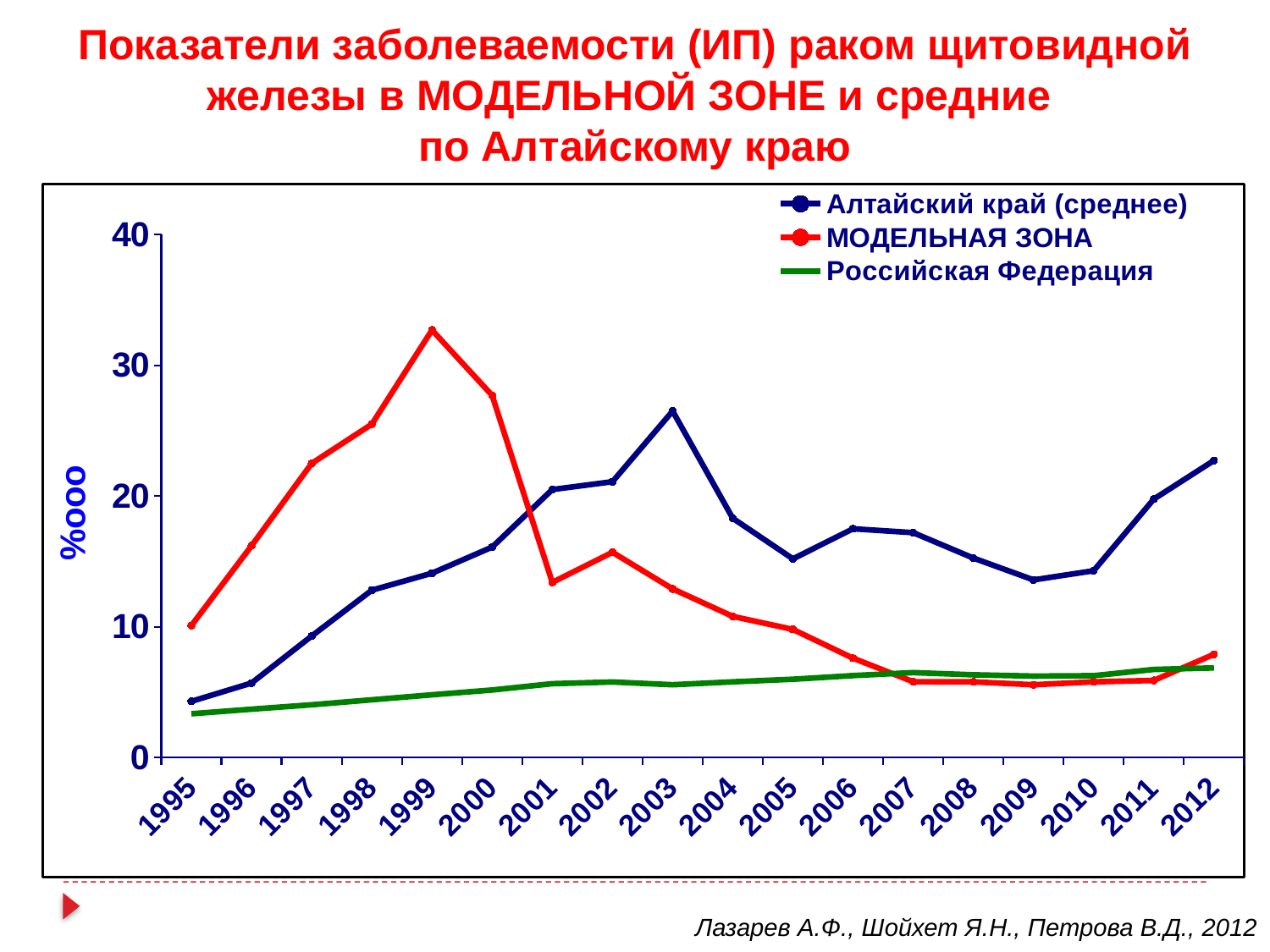
In which year does the Алтайский край (среднее) series reach its highest value? 2003 In which year does the МОДЕЛЬНАЯ ЗОНА series reach its highest value? 1999 How many years are shown along the x axis? 18 What colour is the line for Российская Федерация? green How many series does the legend list? 3 Is the value for Алтайский край (среднее) in 1995 greater or less than 10? less Does the МОДЕЛЬНАЯ ЗОНА series rise or fall from 1999 to 2009? fall What kind of chart is shown on the slide? line chart Which series has the larger value in 2012, Алтайский край (среднее) or МОДЕЛЬНАЯ ЗОНА? Алтайский край (среднее) Is the value for МОДЕЛЬНАЯ ЗОНА in 1999 greater or less than 30? greater Which series has the larger value in 1999, МОДЕЛЬНАЯ ЗОНА or Алтайский край (среднее)? МОДЕЛЬНАЯ ЗОНА Is the value for Российская Федерация in 2012 greater or less than 10? less